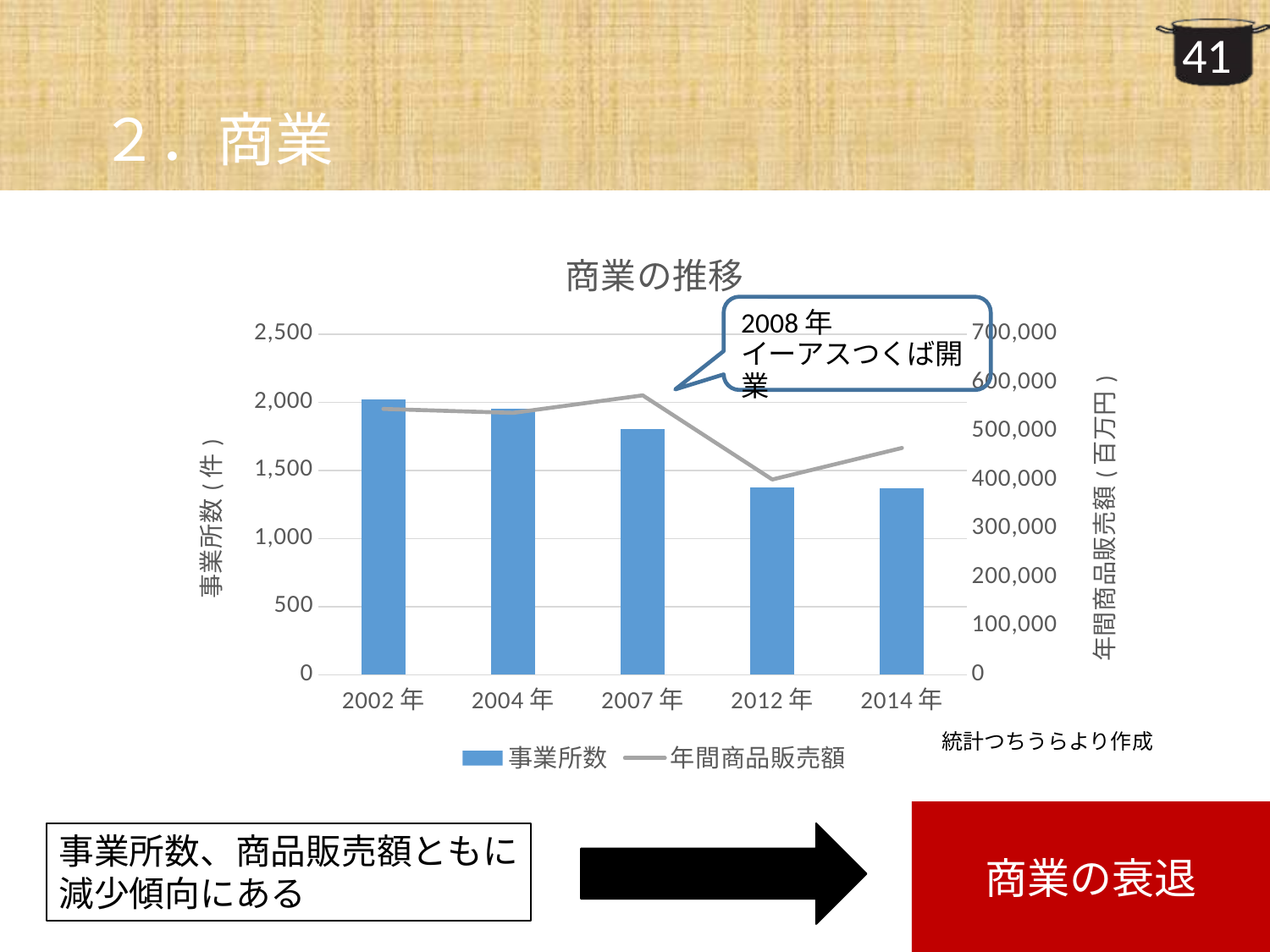
How many series does the chart's legend list? 2 In which year does the 年間商品販売額 line reach its lowest point? 2012年 Do the 事業所数 bars generally rise or fall from 2002年 to 2014年? fall Is the 年間商品販売額 value for 2007年 greater or less than 500,000? greater Which year has the larger 事業所数 bar, 2002年 or 2007年? 2002年 What is the title of the chart? 商業の推移 Which year has the highest bar for 事業所数? 2002年 How many years are shown on the x axis of the chart? 5 Is the 事業所数 value for 2012年 greater or less than 1,500? less What kind of chart is shown on the slide? A combined bar and line chart In which year does the 年間商品販売額 line reach its highest point? 2007年 Is the 事業所数 value for 2007年 greater or less than 2,000? less